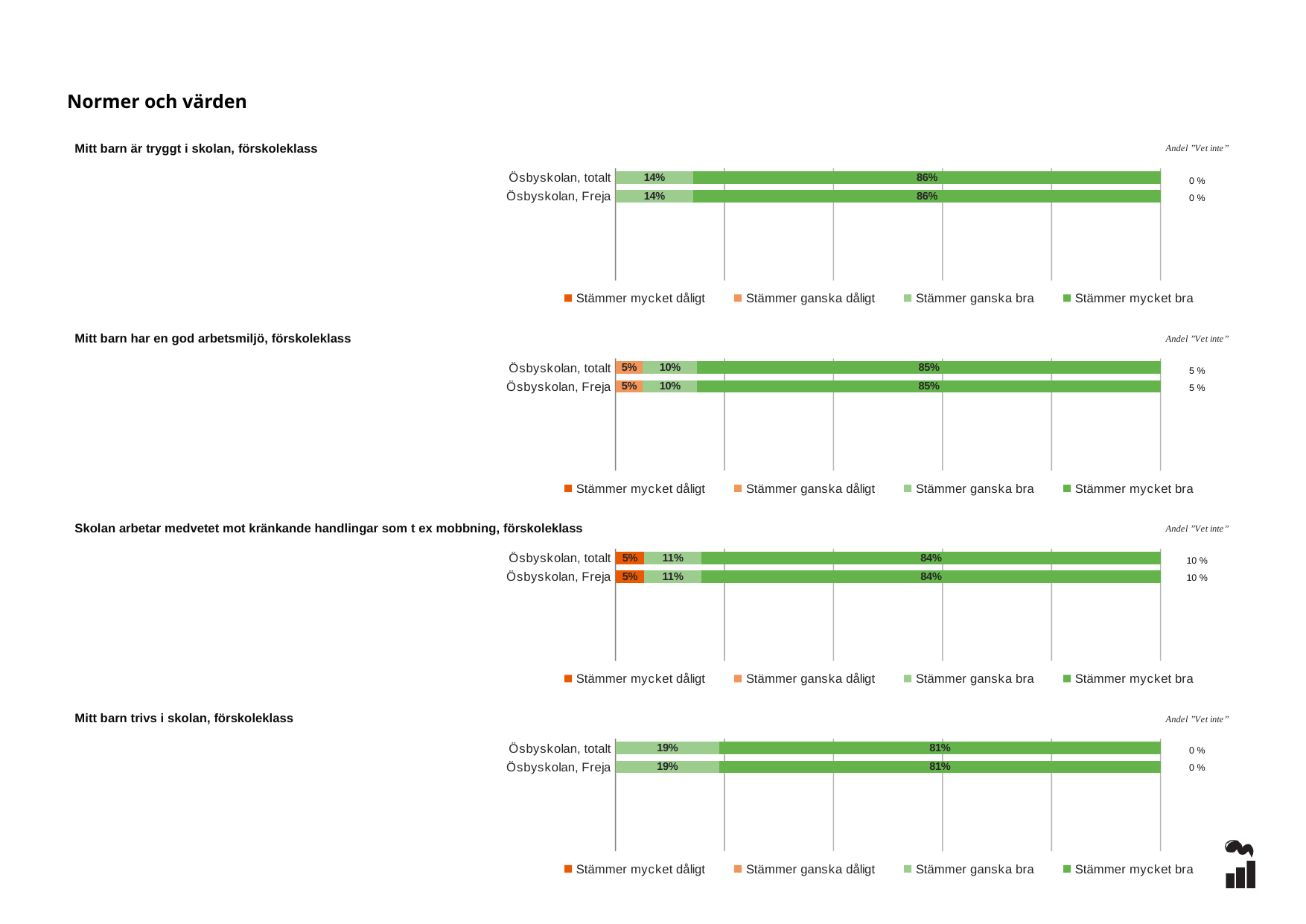
In the chart 'Mitt barn har en god arbetsmiljö, förskoleklass', what is the value of 'Stämmer mycket bra' for Ösbyskolan, totalt? 85% In the chart 'Mitt barn trivs i skolan, förskoleklass', what is the difference between 'Stämmer mycket bra' and 'Stämmer ganska bra' for Ösbyskolan, Freja? 62% In the chart 'Mitt barn har en god arbetsmiljö, förskoleklass', what is the 'Andel Vet inte' value shown for Ösbyskolan, Freja? 5 % In the chart 'Skolan arbetar medvetet mot kränkande handlingar som t ex mobbning, förskoleklass', what is the value of 'Stämmer mycket bra' for Ösbyskolan, Freja? 84% In the chart 'Mitt barn är tryggt i skolan, förskoleklass', what is the value of 'Stämmer ganska bra' for Ösbyskolan, Freja? 14% In the chart 'Mitt barn är tryggt i skolan, förskoleklass', which segment is larger for Ösbyskolan, totalt: 'Stämmer ganska bra' or 'Stämmer mycket bra'? Stämmer mycket bra In the chart 'Mitt barn är tryggt i skolan, förskoleklass', what is the value of 'Stämmer mycket bra' for Ösbyskolan, totalt? 86% In the chart 'Skolan arbetar medvetet mot kränkande handlingar som t ex mobbning, förskoleklass', what is the 'Andel Vet inte' value for Ösbyskolan, totalt? 10 % What type of chart is used for 'Skolan arbetar medvetet mot kränkande handlingar som t ex mobbning, förskoleklass'? Stacked bar chart In the chart 'Mitt barn trivs i skolan, förskoleklass', what is the value of 'Stämmer ganska bra' for Ösbyskolan, totalt? 19% How many series does the legend list in the chart 'Mitt barn har en god arbetsmiljö, förskoleklass'? 4 How many categories (rows) are shown in the chart 'Mitt barn trivs i skolan, förskoleklass'? 2